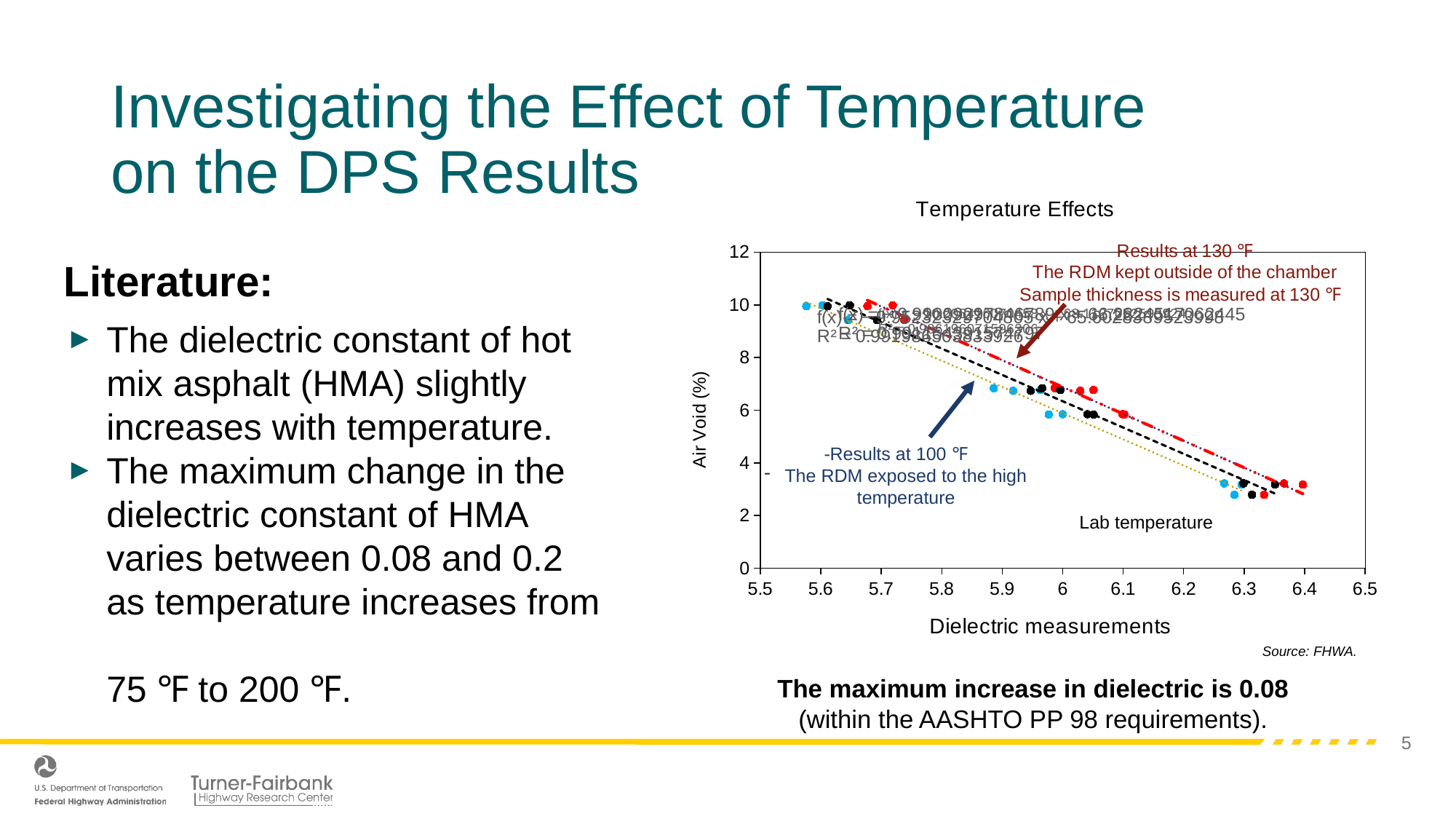
Is the air void value for the points near a dielectric measurement of 5.6 greater or less than 8? greater What is the title of the chart? Temperature Effects Which temperature condition is annotated in red on the chart? Results at 130 °F As the dielectric measurements increase along the x axis, do the air void values rise or fall? Fall Is the air void value for the blue points near a dielectric measurement of 5.9 greater or less than 6? greater What is the label of the y axis of the chart? Air Void (%) What is the highest value shown on the x axis of the chart? 6.5 What is the highest value shown on the y axis of the chart? 12 What kind of chart is shown on the slide? Scatter plot What is the lowest value shown on the x axis of the chart? 5.5 Is the air void value for the red points near a dielectric measurement of 6.4 greater or less than 4? less